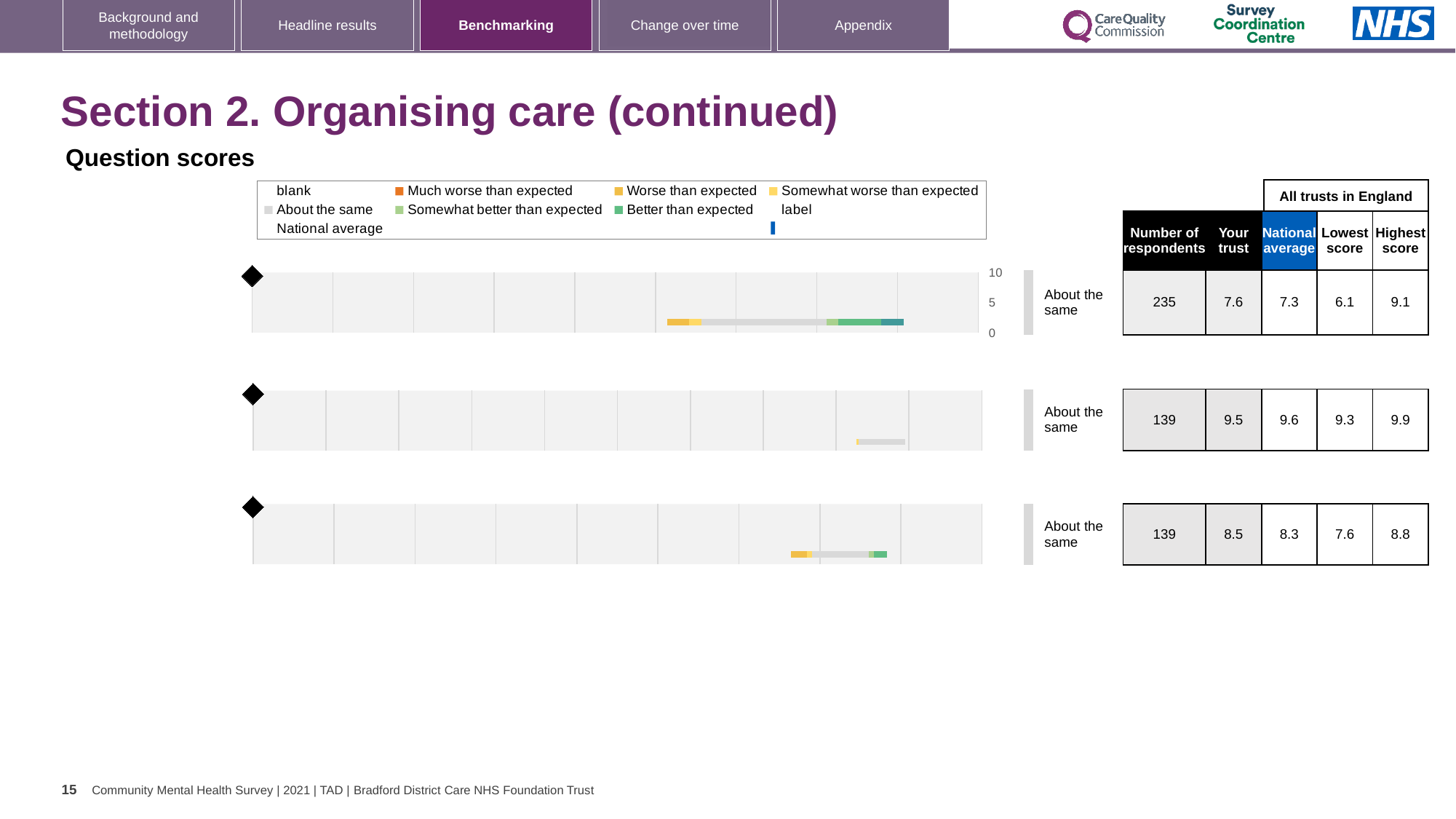
For the middle chart, which is larger: the Your trust score or the National average? National average For the top chart, what is the National average shown in the table? 7.3 What kind of chart is used for the question scores on this slide? Bar chart For the top chart, what is the score for Your trust shown in the table? 7.6 For the bottom chart, what is the National average shown in the table? 8.3 For the top chart, what is the difference between the Highest score and the Lowest score? 3.0 For the middle chart, what is the score for Your trust shown in the table? 9.5 For the bottom chart, what is the Lowest score across all trusts in England? 7.6 For the top chart, which is larger: the Your trust score or the National average? Your trust For the middle chart, what is the Highest score across all trusts in England? 9.9 What benchmark category is shown next to the bottom chart? About the same For the top chart, how many respondents are listed in the table? 235